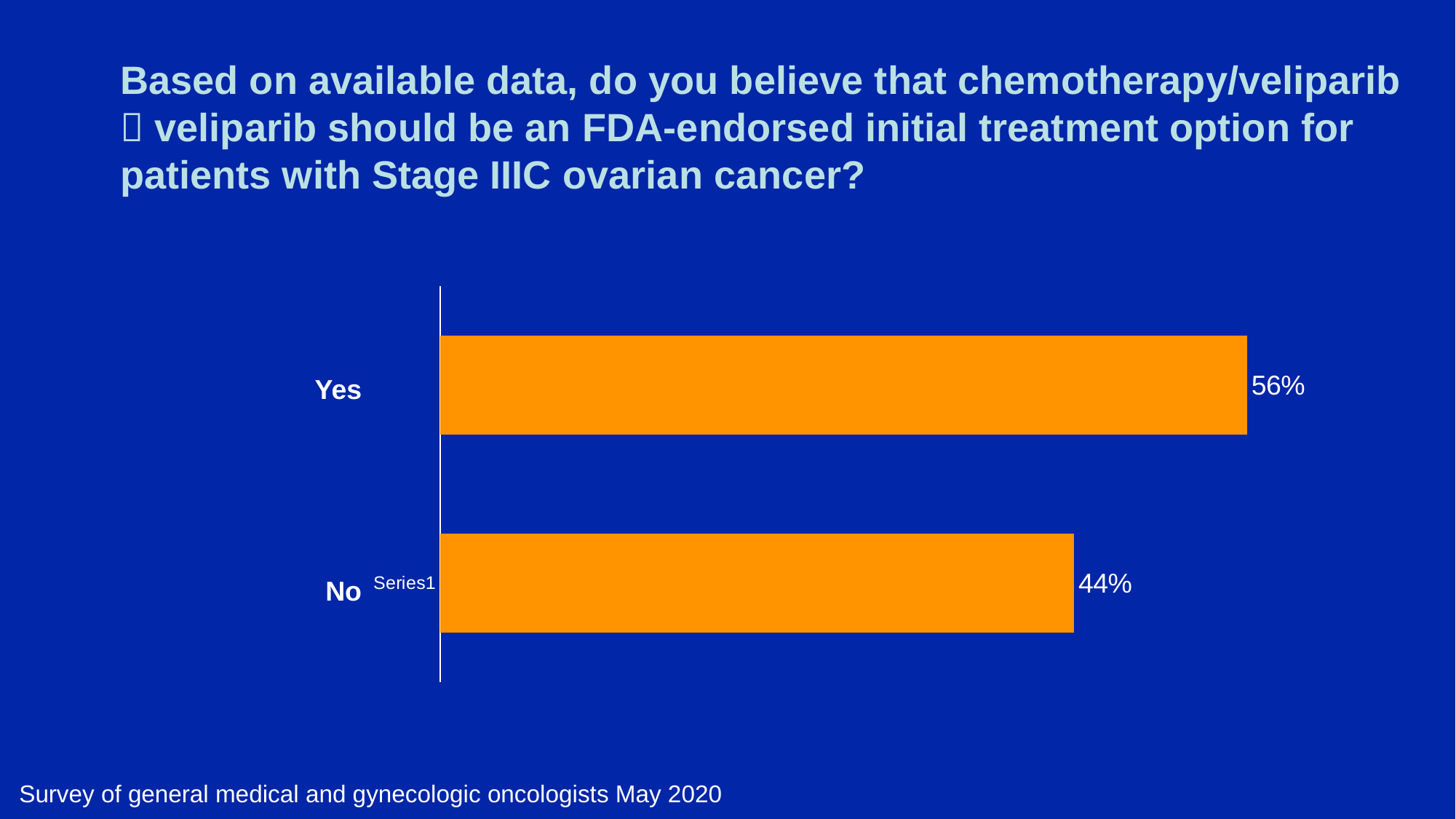
What colour are the bars in the chart? Orange What is the total of the Yes and No percentages? 100% Which response category has the lowest value? No How many response categories are shown in the chart? 2 What kind of chart is shown on the slide? Bar chart Which is larger, the value for Yes or the value for No? Yes What percentage of respondents answered No? 44% What percentage of respondents answered Yes? 56% According to the footnote, who was surveyed and when? General medical and gynecologic oncologists, May 2020 What is the difference between the Yes and No percentages? 12% Which response category has the highest value? Yes